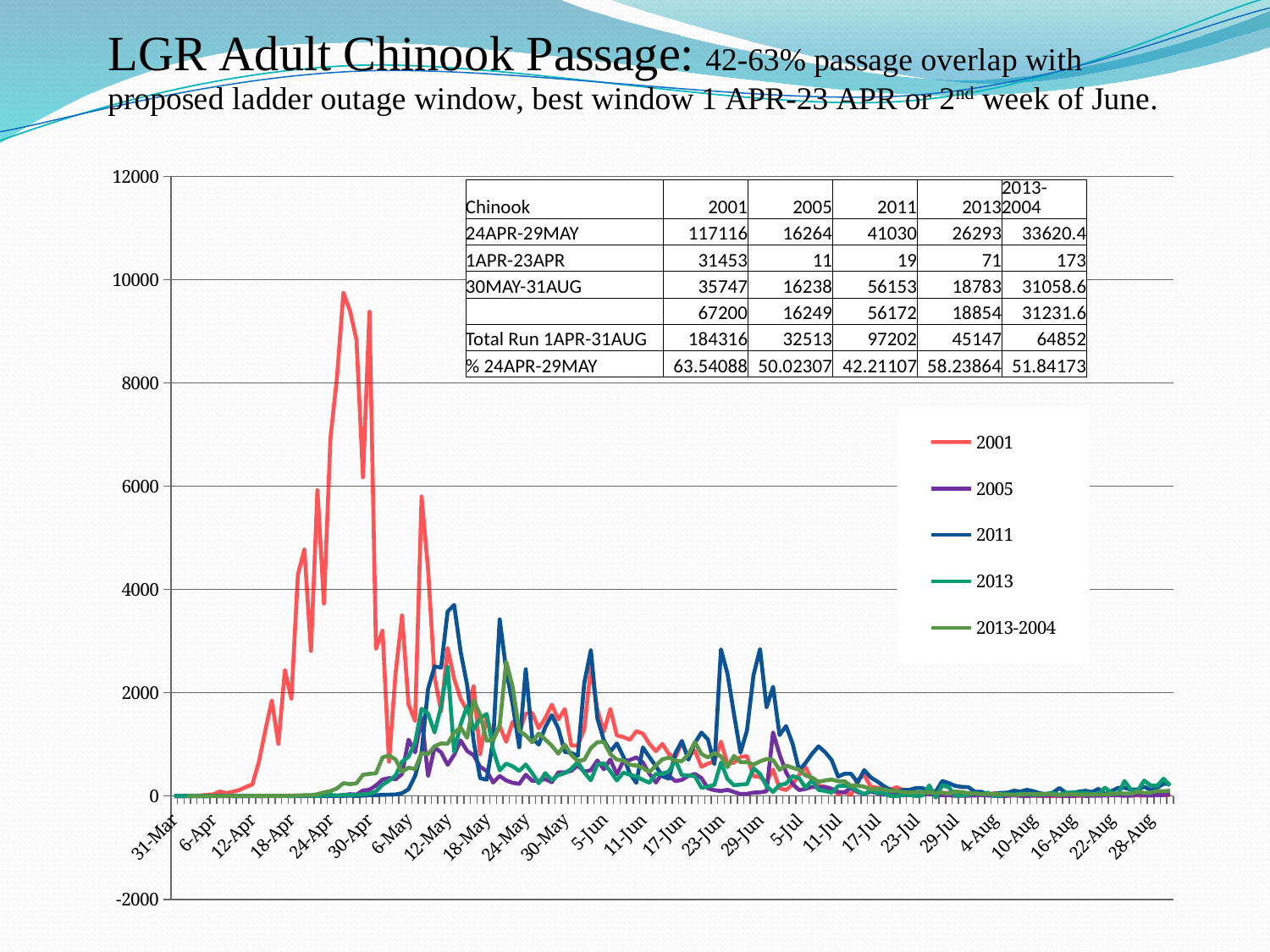
How many series does the legend list? 5 What is the highest value shown on the vertical axis? 12000 Which series has a higher peak, 2001 or 2011? 2001 According to the table on the chart, what is the 1APR-23APR value for 2005? 11 Is the peak value of the 2011 series greater or less than 4000? less According to the table on the chart, what is the 24APR-29MAY value for 2011? 41030 What is the first date label on the horizontal axis? 31-Mar Which series reaches the highest peak value on the chart? 2001 Is the peak value of the 2005 series greater or less than 2000? less What kind of chart is shown on the slide? line chart Is the peak value of the 2001 series greater or less than 8000? greater According to the table on the chart, what is the Total Run 1APR-31AUG value for 2001? 184316